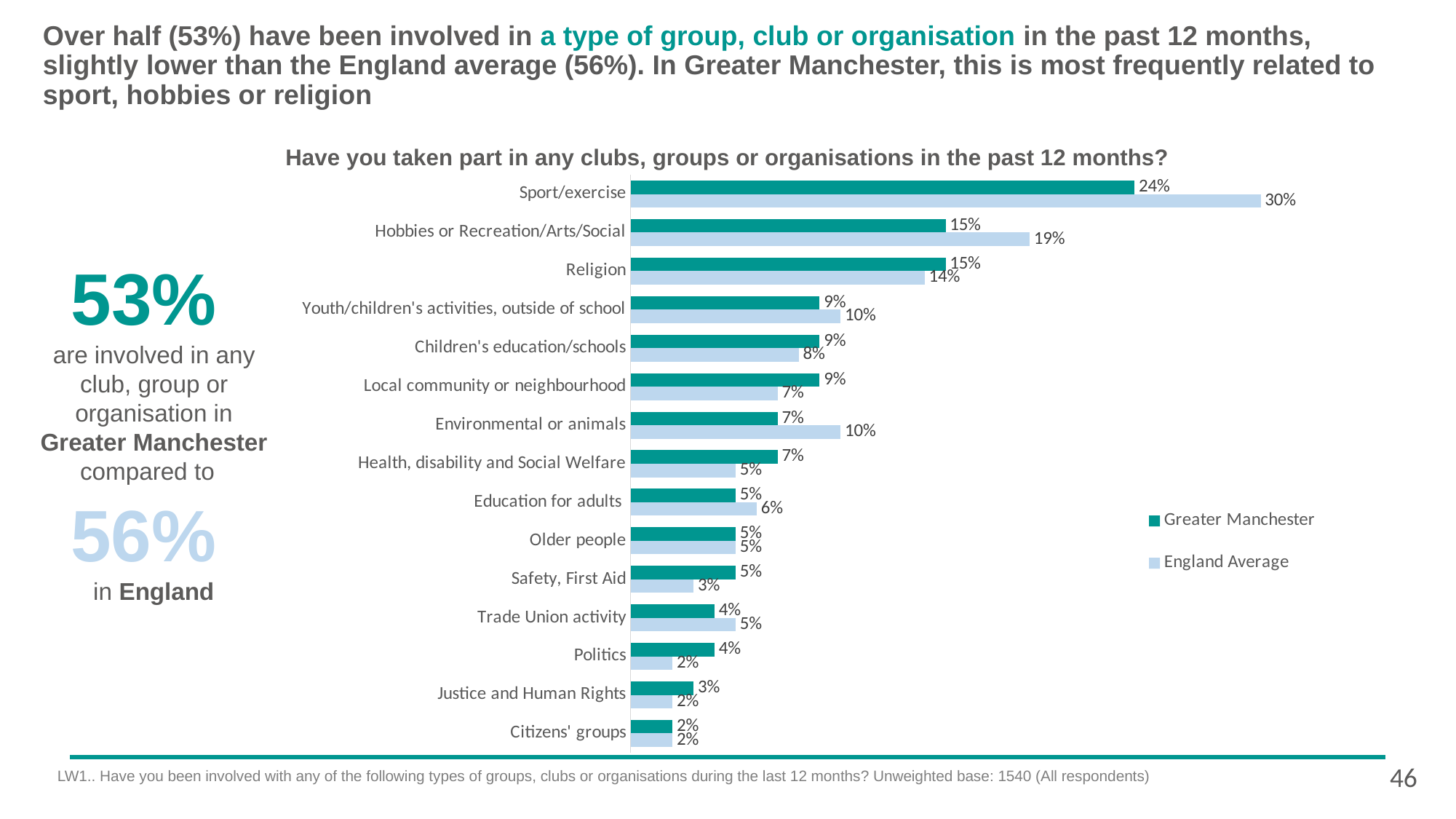
How many series does the legend list? 2 What is the England Average value for Safety, First Aid? 3% What kind of chart is shown on the slide? Bar chart What is the England Average value for Hobbies or Recreation/Arts/Social? 19% For Religion, which is larger: the Greater Manchester value or the England Average value? Greater Manchester Which category has the lowest Greater Manchester value? Citizens' groups Which category has the highest England Average value? Sport/exercise What is the difference between the England Average and Greater Manchester values for Sport/exercise? 6% What is the difference between the Greater Manchester and England Average values for Politics? 2% What is the Greater Manchester value for Sport/exercise? 24% How many categories are shown in the chart? 15 For Environmental or animals, which is larger: the Greater Manchester value or the England Average value? England Average